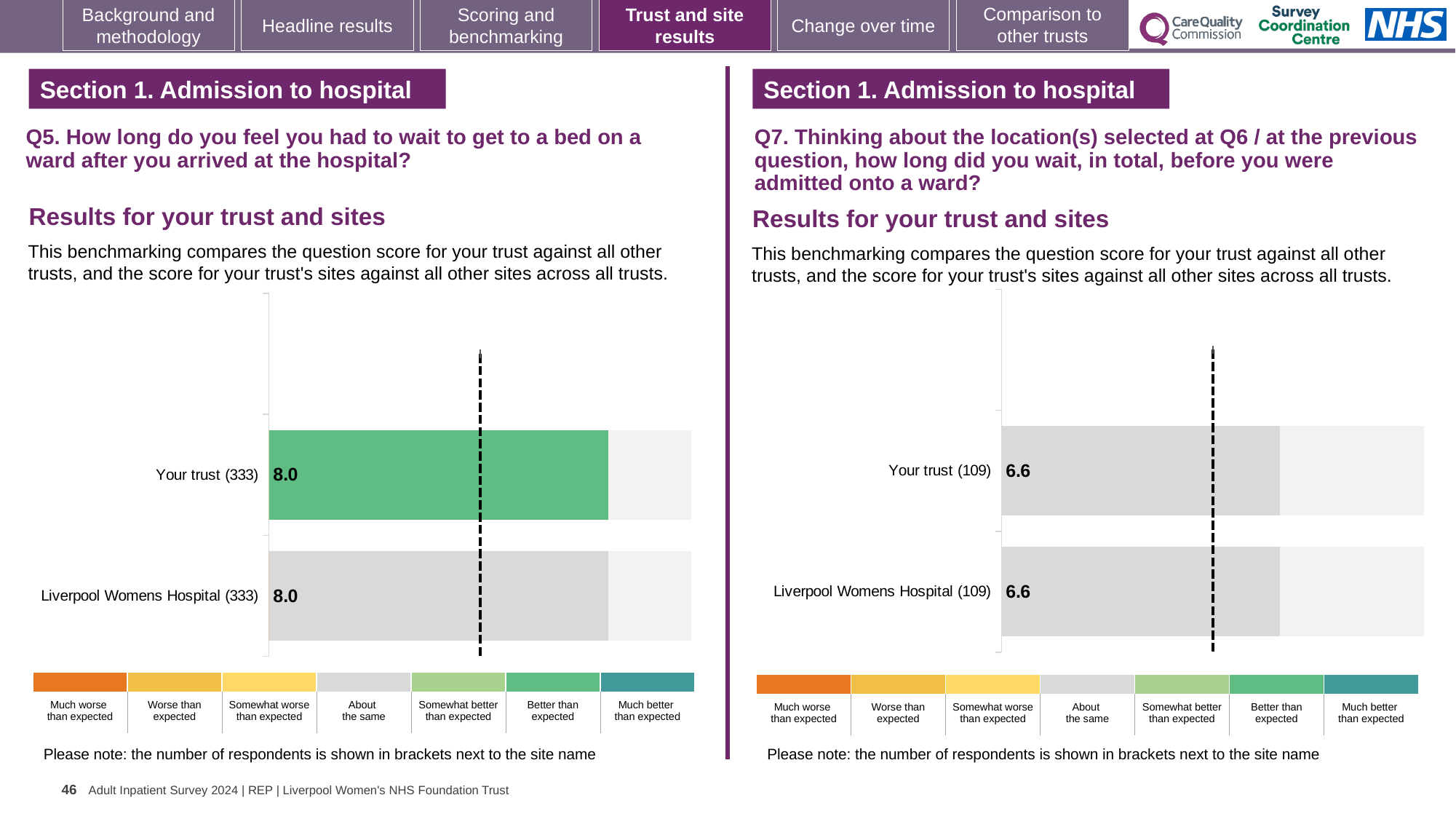
In the Q7 chart on the right, what is the score for Your trust (109)? 6.6 In the Q5 chart on the left, which benchmark category does the colour of the Your trust bar correspond to according to the legend? Better than expected In the Q5 chart on the left, what is the score for Your trust (333)? 8.0 In the Q5 chart on the left, what is the difference between the score for Your trust and the score for Liverpool Womens Hospital? 0.0 In the Q5 chart on the left, is the score for Your trust greater or less than the score for Liverpool Womens Hospital, or are they equal? Equal In the Q5 chart on the left, what is the score for Liverpool Womens Hospital (333)? 8.0 How many bars are plotted in the Q5 chart on the left? 2 In the Q7 chart on the right, what is the score for Liverpool Womens Hospital (109)? 6.6 In the Q7 chart on the right, how many respondents are shown in brackets next to Your trust? 109 How many bars are plotted in the Q7 chart on the right? 2 What kind of chart is the Q5 chart on the left? Bar chart